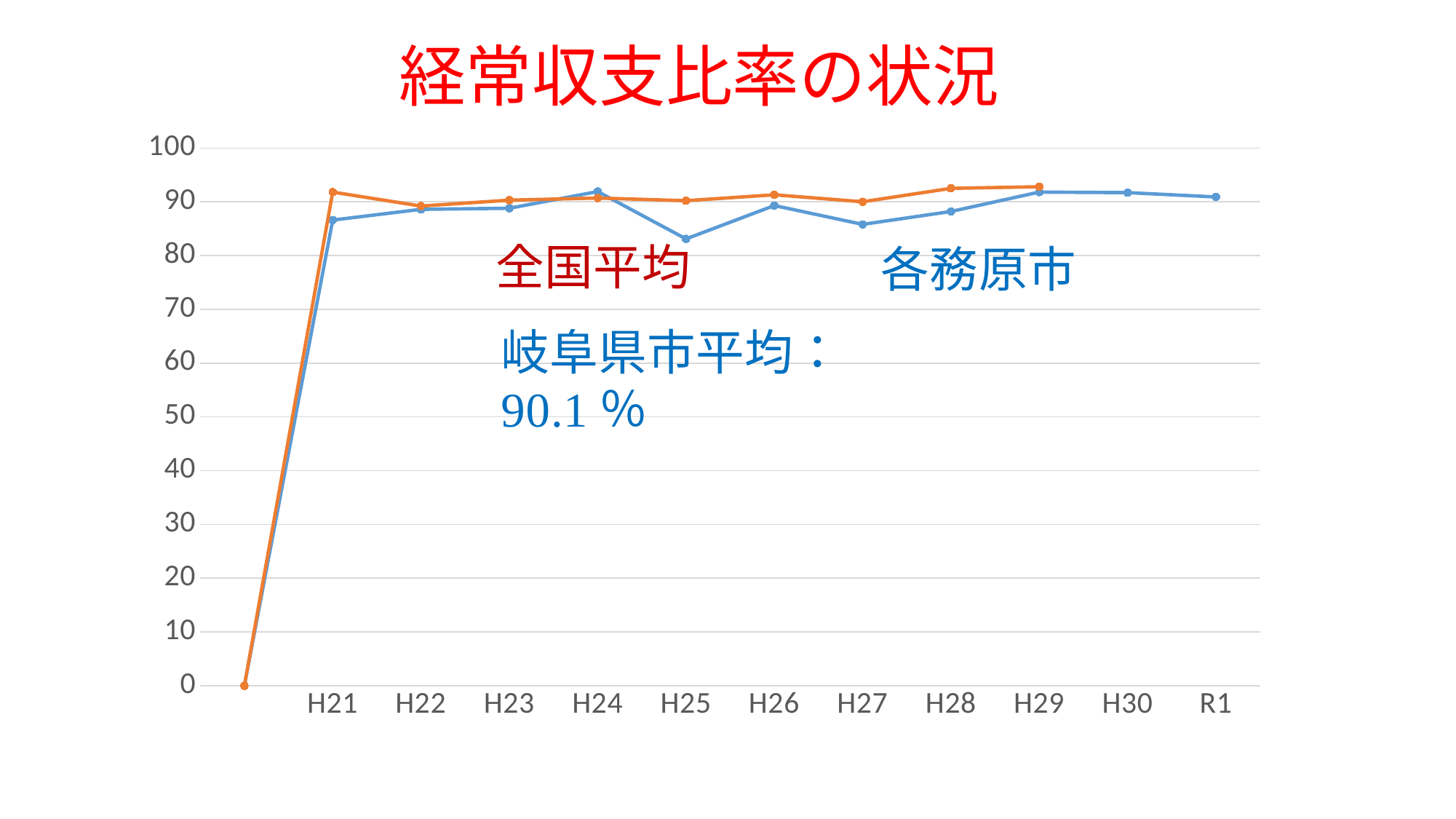
How many series are plotted in the chart? 2 In H21, which series has the larger value, 全国平均 or 各務原市? 全国平均 How many labeled years are shown on the x axis? 11 Is the value for 各務原市 in H27 greater or less than 90? less Among the labeled years, in which year is the value for 各務原市 lowest? H25 Is the value for 全国平均 in H21 greater or less than 90? greater What is the title of the chart? 経常収支比率の状況 In H25, which series has the larger value, 全国平均 or 各務原市? 全国平均 What kind of chart is shown on the slide? line chart What value is given on the slide for 岐阜県市平均? 90.1％ Does the value for 各務原市 rise or fall from H25 to H26? rise Is the value for 各務原市 in H25 greater or less than 90? less